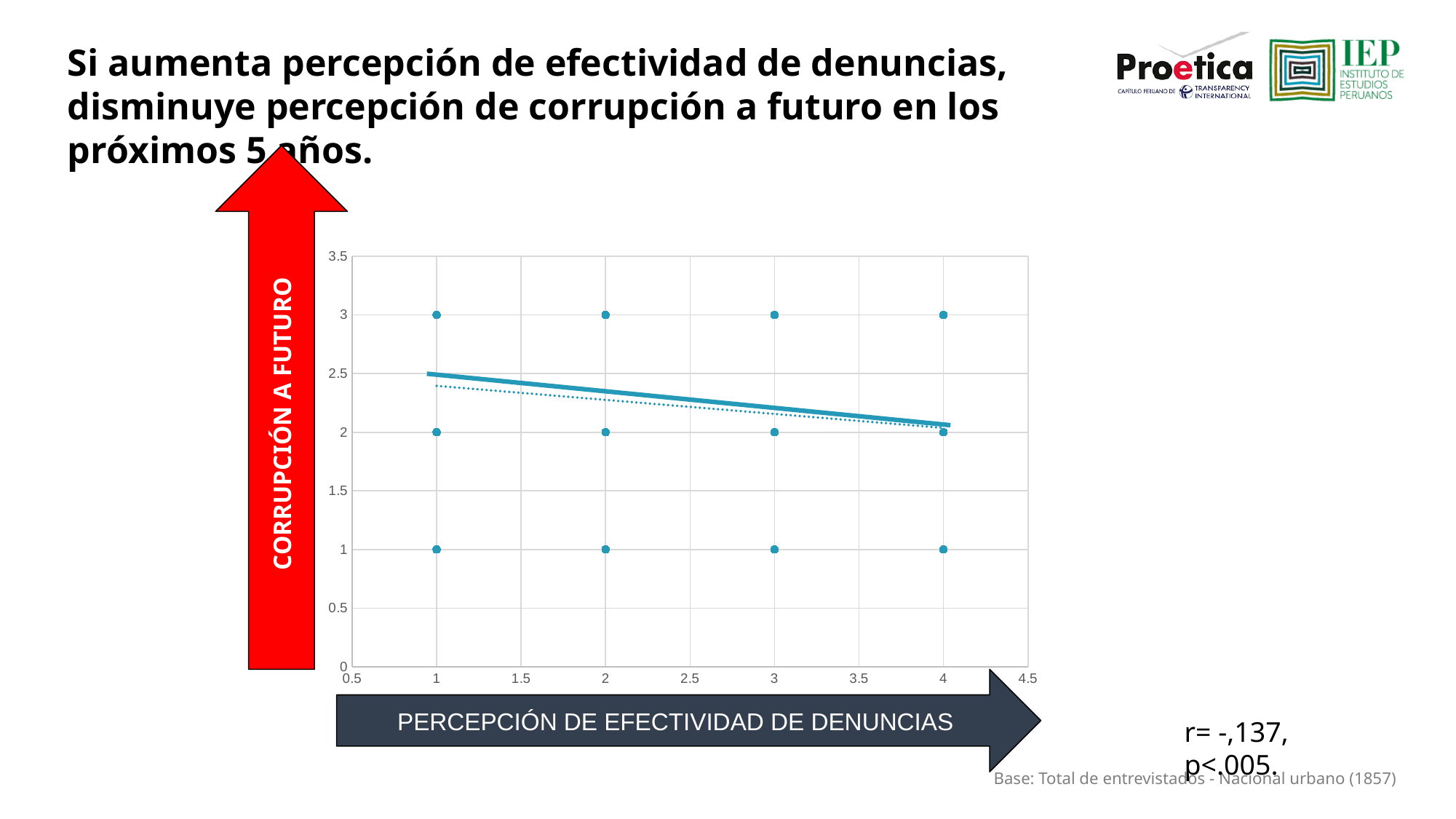
What is the label of the vertical axis? CORRUPCIÓN A FUTURO What is the lowest y value reached by any plotted point? 1 Does the trend line rise or fall as the x axis value increases? Falls What is the label of the horizontal axis? PERCEPCIÓN DE EFECTIVIDAD DE DENUNCIAS What is the highest y value reached by any plotted point? 3 What is the maximum value shown on the y axis? 3.5 What y values do the plotted points at x = 1 take? 1, 2 and 3 What is the largest x value at which points are plotted? 4 What kind of chart is shown on the slide? Scatter chart Is the trend line's value at x = 4 greater or less than 2.5? less Is the trend line's value at x = 1 greater or less than 2? greater